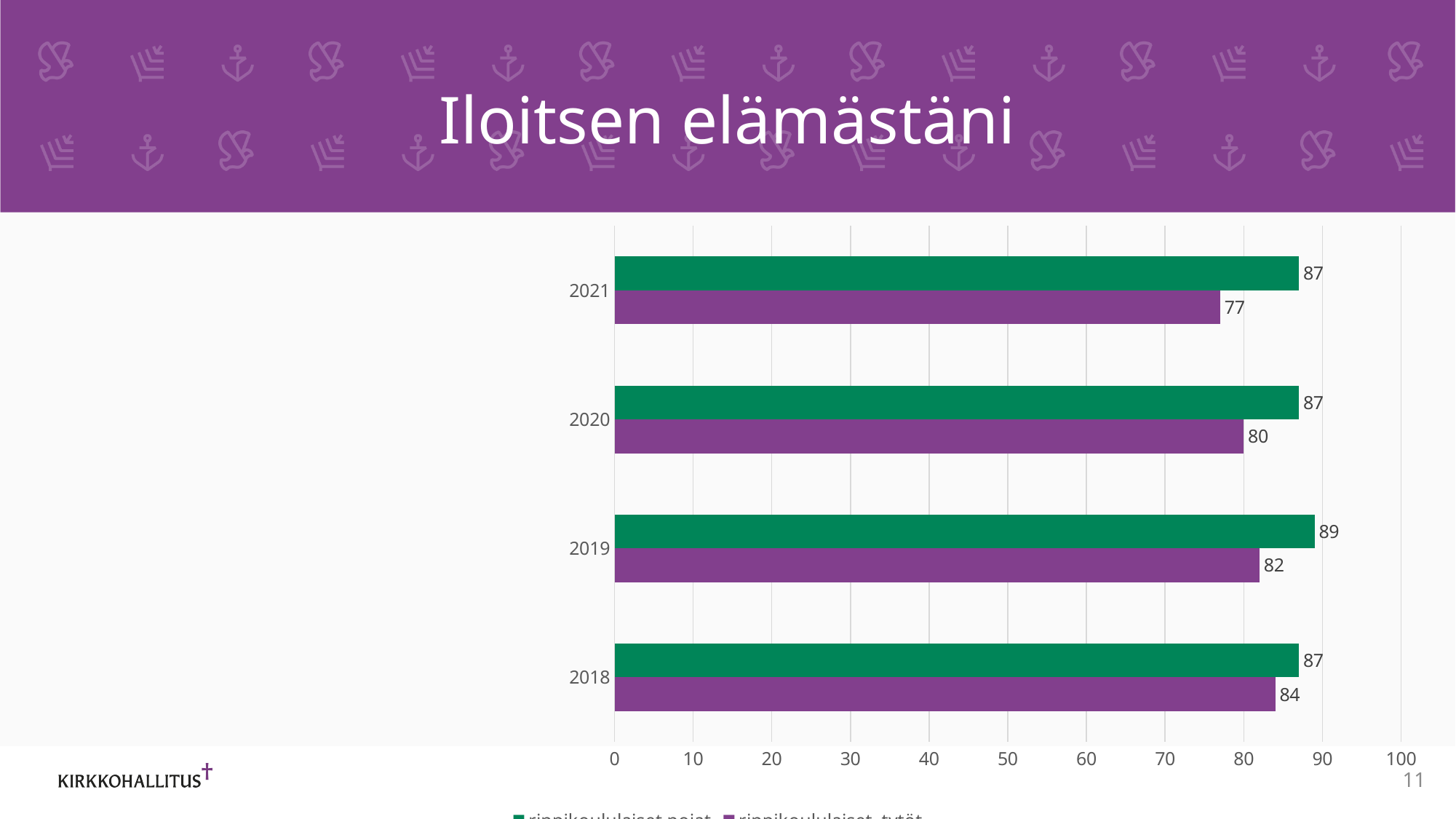
What is the difference between the green and purple bars for 2021? 10 In which year is the green bar the highest? 2019 What is the value of the green bar for 2021? 87 For 2020, which bar is larger, the green or the purple? green Do the purple bar values rise or fall from 2018 to 2021? fall What type of chart is shown on the slide? bar chart In which year is the purple bar the lowest? 2021 How many years are shown on the chart? 4 What is the value of the purple bar for 2018? 84 What is the difference between the green and purple bars for 2019? 7 What is the value of the green bar for 2019? 89 What is the value of the purple bar for 2021? 77